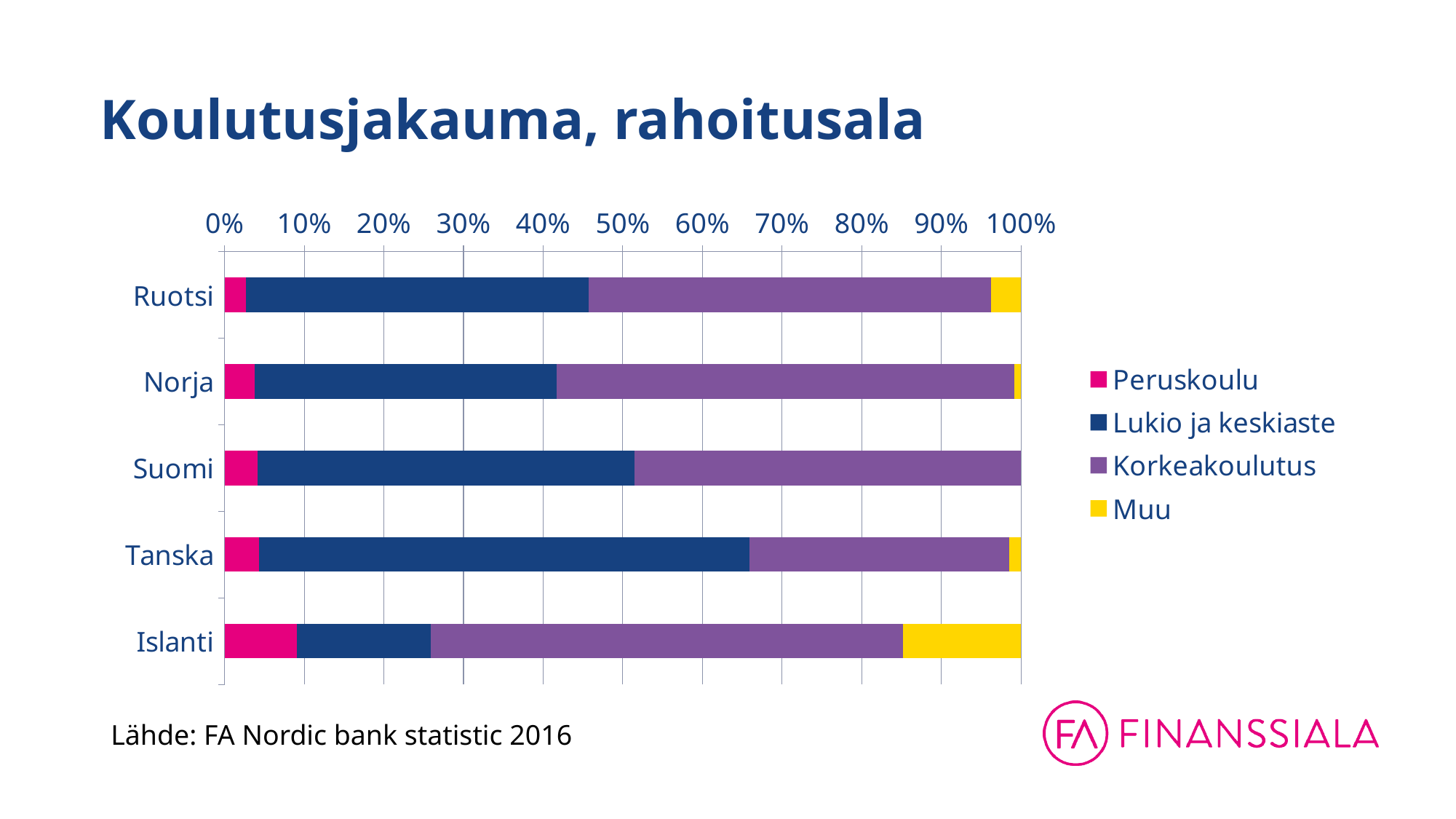
Is the Lukio ja keskiaste share for Tanska greater or less than 50%? greater Which country has the largest Muu share? Islanti How many countries are shown on the chart? 5 Which has the larger Lukio ja keskiaste share, Suomi or Norja? Suomi Which country has the smallest Lukio ja keskiaste share? Islanti Is the Muu share for Islanti greater or less than 10%? greater What kind of chart is shown on the slide? Stacked bar chart Which country has the largest Lukio ja keskiaste share? Tanska How many series does the legend list? 4 Which country has the largest Peruskoulu share? Islanti Which has the larger Korkeakoulutus share, Ruotsi or Tanska? Ruotsi What colour represents Muu in the legend? Yellow